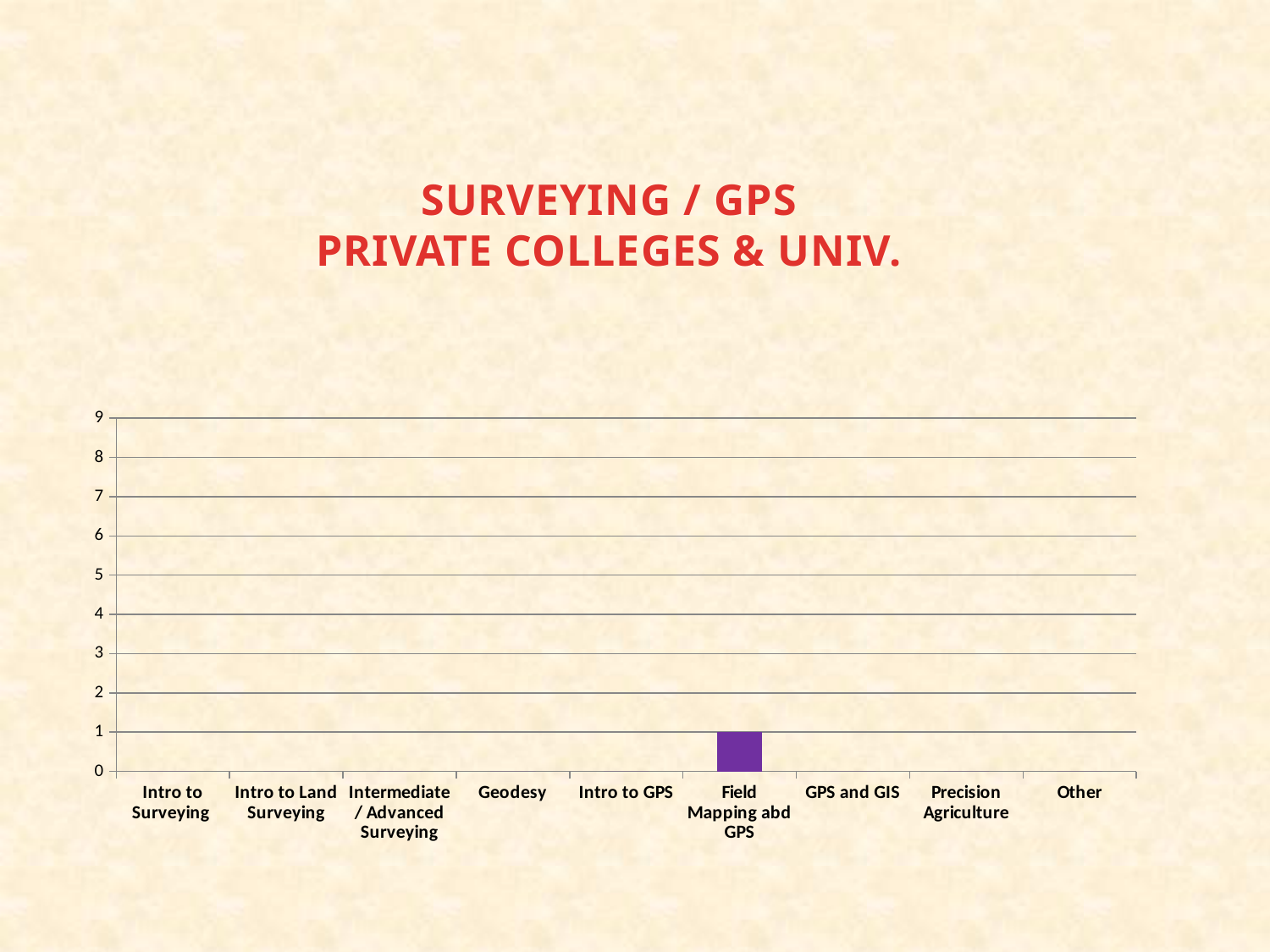
Which category has the highest value? Field Mapping abd GPS What is the value for Field Mapping abd GPS? 1 How many categories are shown on the x axis? 9 What type of chart is shown on the slide? bar chart What is the highest value shown on the y axis? 9 Which is larger, the value for Field Mapping abd GPS or the value for Geodesy? Field Mapping abd GPS How many categories have a visible bar? 1 What is the title of the chart? SURVEYING / GPS PRIVATE COLLEGES & UNIV. Which is larger, the value for Field Mapping abd GPS or the value for GPS and GIS? Field Mapping abd GPS Is the value for Field Mapping abd GPS greater or less than 5? less